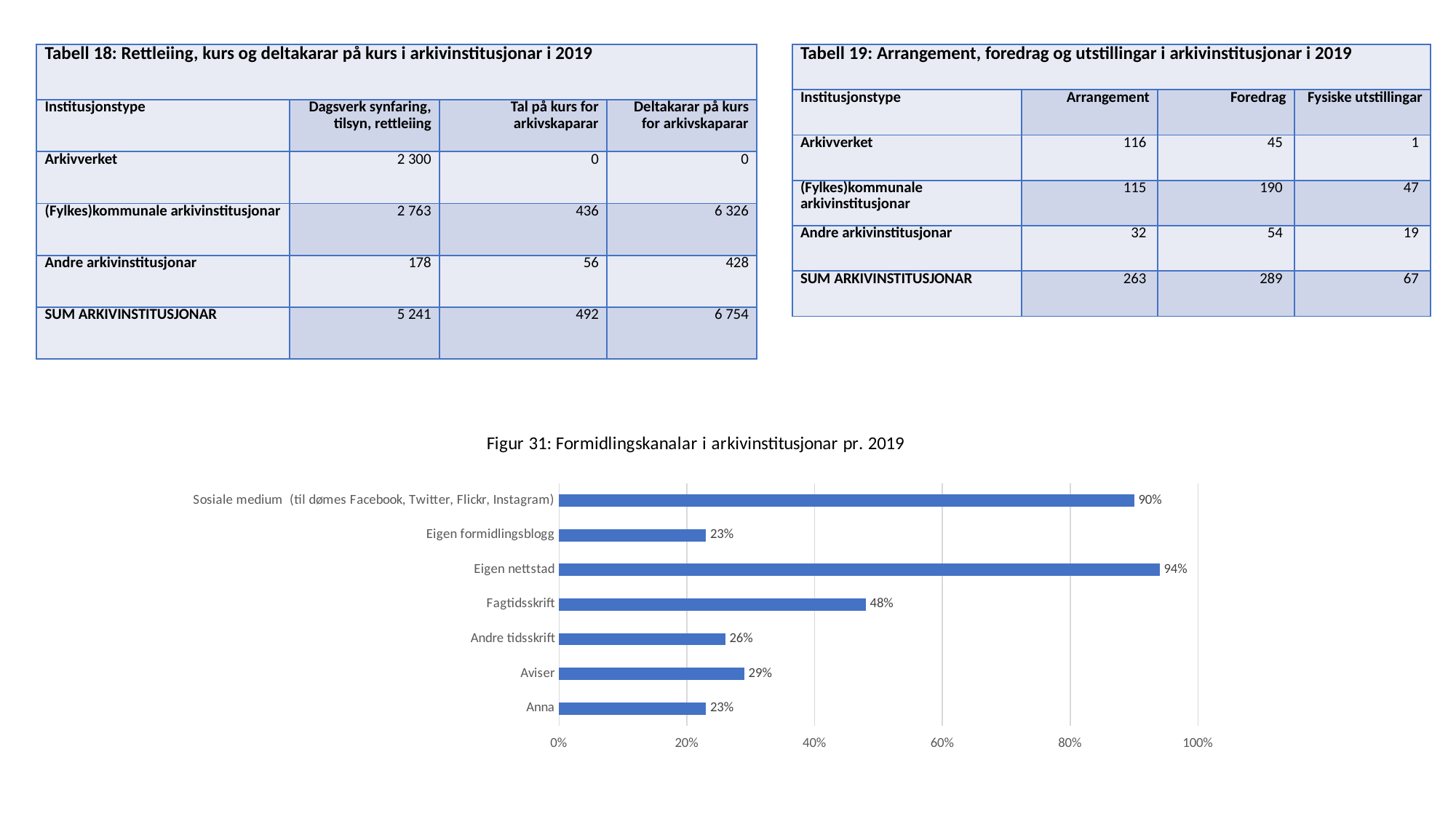
In Figur 31, what is the value for Fagtidsskrift? 48% In Figur 31, how many categories are shown? 7 In Figur 31, which is larger, the value for Aviser or the value for Andre tidsskrift? Aviser In Figur 31, what is the difference between the values for Fagtidsskrift and Eigen formidlingsblogg? 25% In Figur 31, what is the value for Aviser? 29% In Figur 31, what is the value for Eigen nettstad? 94% In Figur 31, is the value for Fagtidsskrift greater or less than 40%? greater In Figur 31, what is the value for Sosiale medium (til dømes Facebook, Twitter, Flickr, Instagram)? 90% What is the title of the chart on the slide? Figur 31: Formidlingskanalar i arkivinstitusjonar pr. 2019 In Figur 31, what is the difference between the values for Eigen nettstad and Sosiale medium? 4% What kind of chart is Figur 31? Bar chart In Figur 31, which category has the highest value? Eigen nettstad